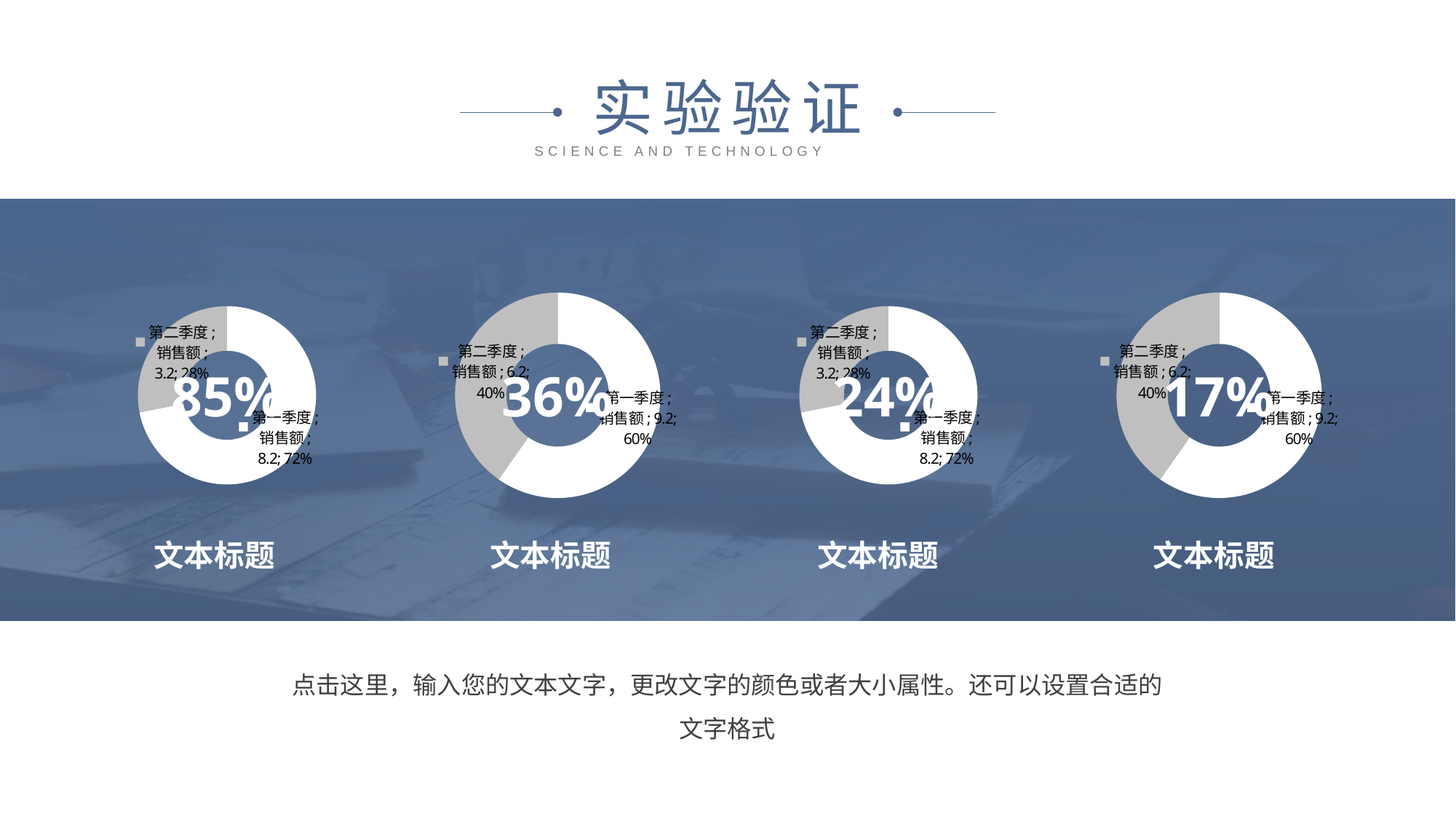
In the second chart from the left, what is the value labelled for 第二季度 销售额? 6.2 How many slices does the rightmost chart have? 2 In the second chart from the left, which slice is larger, 第一季度 or 第二季度? 第一季度 In the third chart from the left, which slice is the smallest? 第二季度 In the leftmost chart, what percentage share is labelled for 第二季度 销售额? 28% How many doughnut charts are shown on the slide? 4 What kind of chart is the leftmost chart on the slide? doughnut chart In the rightmost chart, what is the value labelled for 第一季度 销售额? 9.2 In the rightmost chart, what percentage share is labelled for 第二季度 销售额? 40% In the second chart from the left, what percentage share is labelled for 第一季度 销售额? 60% In the leftmost chart, what is the value labelled for 第一季度 销售额? 8.2 In the third chart from the left, what is the difference between the 第一季度 value (8.2) and the 第二季度 value (3.2)? 5.0